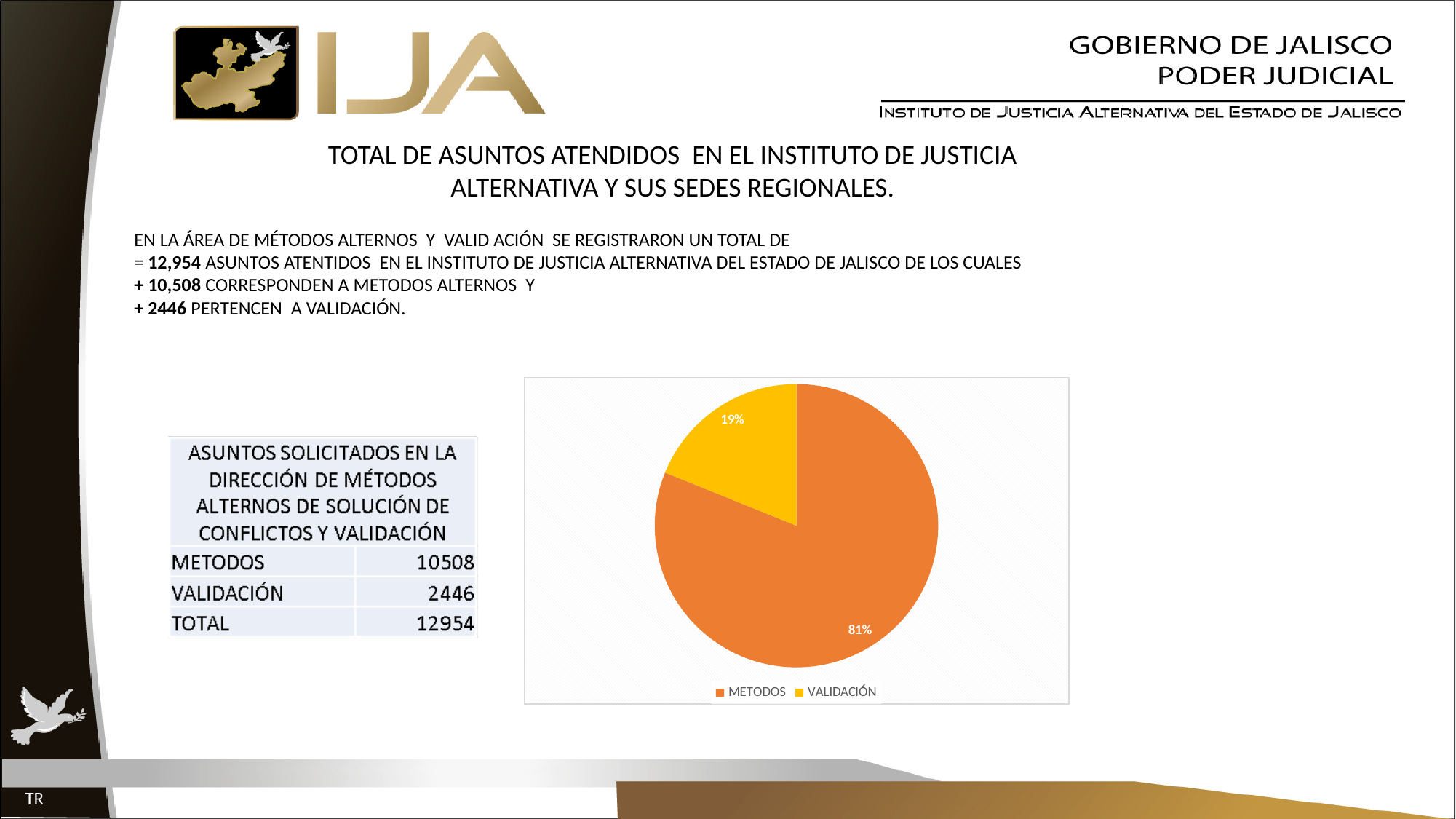
How many slices does the pie chart have? 2 Which slice of the pie is the smallest? VALIDACIÓN Which slice of the pie is the largest? METODOS Which is larger, the METODOS slice or the VALIDACIÓN slice? METODOS What colour is the METODOS slice in the pie chart? orange What colour is the VALIDACIÓN slice in the pie chart? yellow What kind of chart is shown on the slide? pie chart How many entries does the legend list? 2 What share of the pie does VALIDACIÓN represent? 19% What is the difference in percentage points between the METODOS slice and the VALIDACIÓN slice? 62 What share of the pie does METODOS represent? 81%